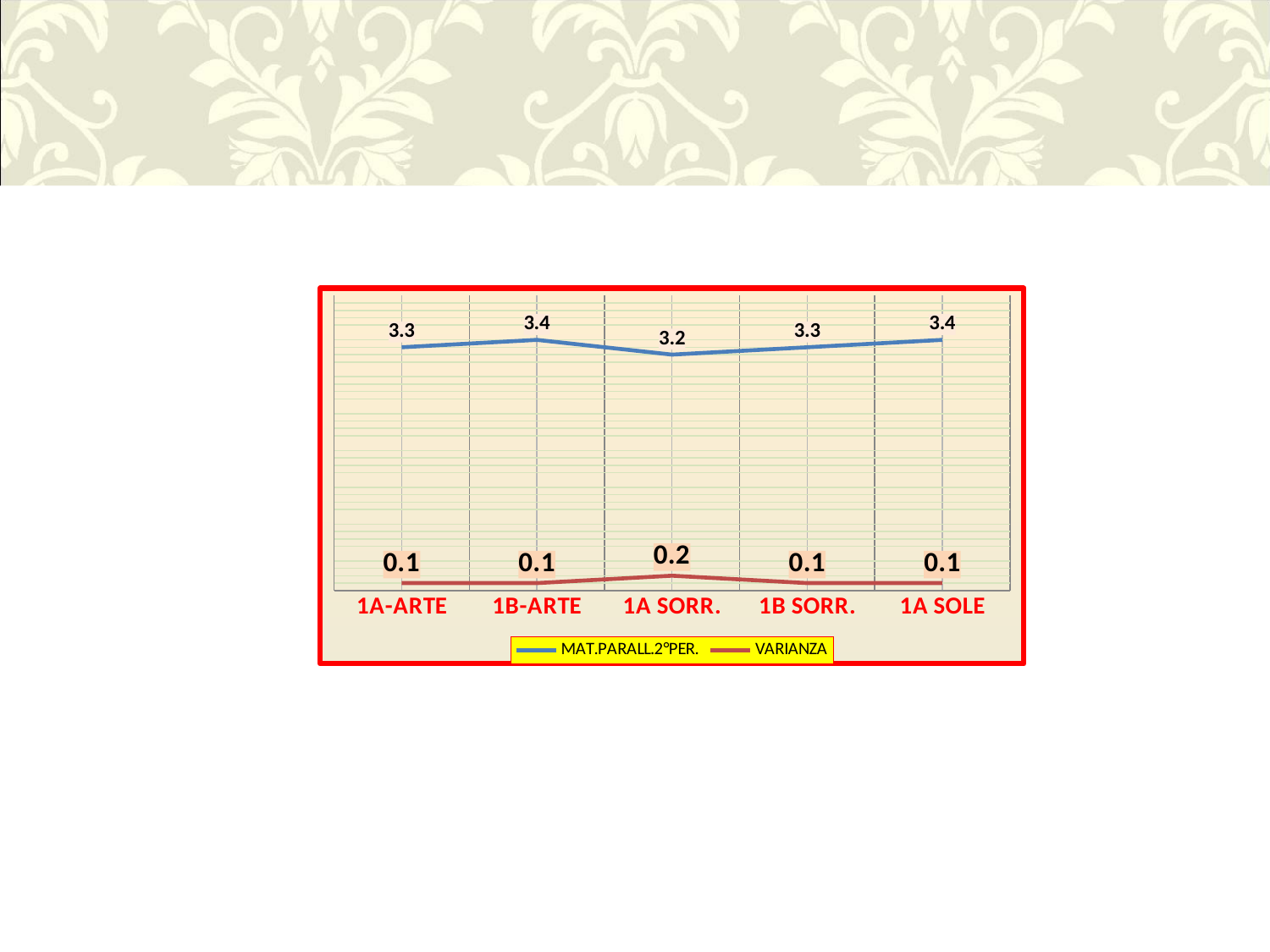
What is the MAT.PARALL.2°PER. value for 1A SORR.? 3.2 What is the difference between the MAT.PARALL.2°PER. values for 1B-ARTE and 1A SORR.? 0.2 Which category has the lowest MAT.PARALL.2°PER. value? 1A SORR. Which is larger, the MAT.PARALL.2°PER. value for 1A-ARTE or for 1A SOLE? 1A SOLE What is the VARIANZA value for 1A SORR.? 0.2 Which category has the highest VARIANZA value? 1A SORR. What colour is the line for the VARIANZA series? red What is the MAT.PARALL.2°PER. value for 1B-ARTE? 3.4 How many categories are shown on the x axis? 5 What is the VARIANZA value for 1B SORR.? 0.1 How many series does the legend list? 2 What kind of chart is shown on the slide? line chart